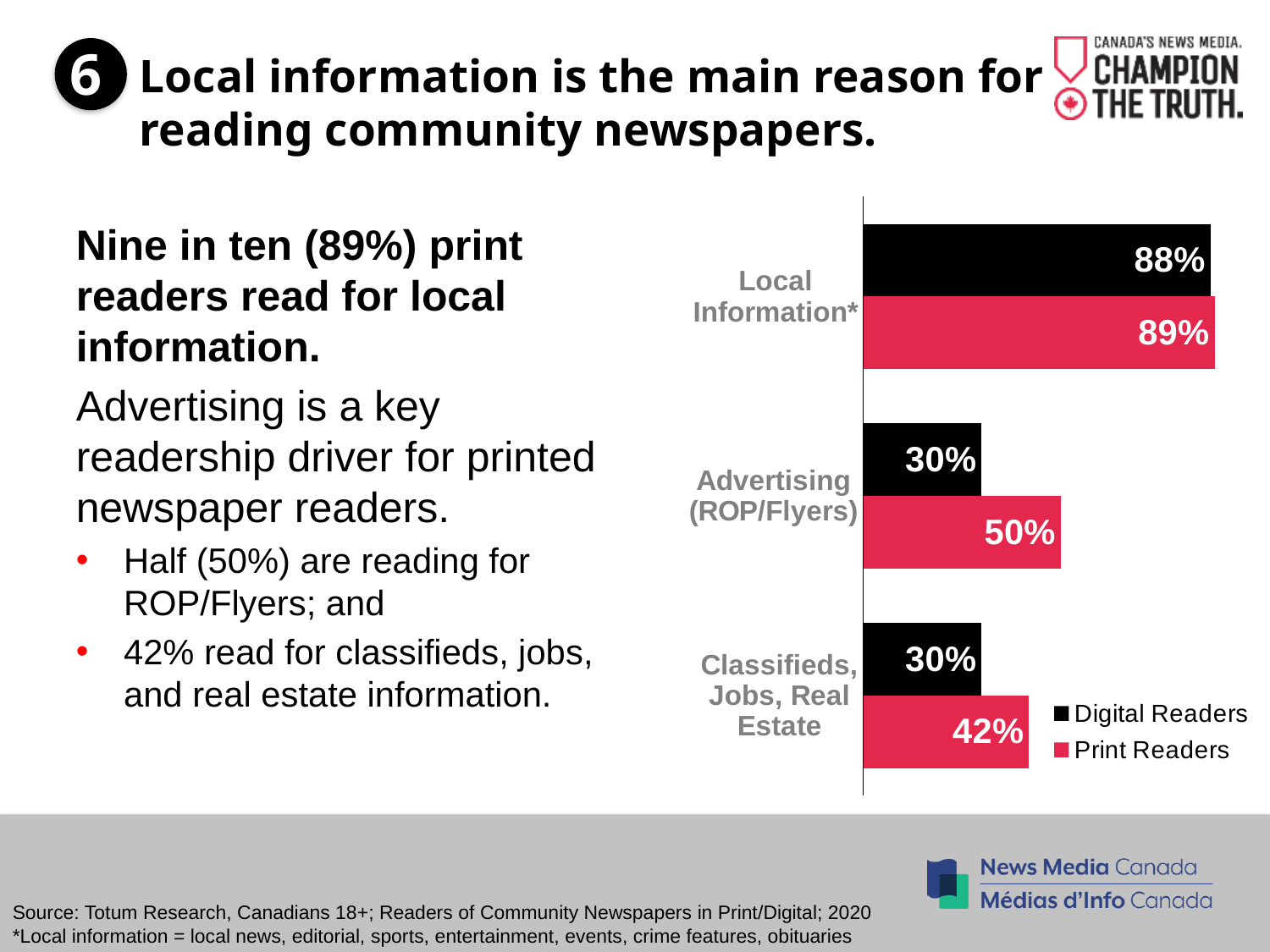
How many series does the legend list? 2 What is the difference between Print Readers and Digital Readers for Classifieds, Jobs, Real Estate? 12% What percentage of Print Readers read for Classifieds, Jobs, Real Estate? 42% What percentage of Print Readers read for Local Information? 89% Which category has the lowest value for Print Readers? Classifieds, Jobs, Real Estate What kind of chart is shown on the slide? Bar chart Which is larger for Advertising (ROP/Flyers): Digital Readers or Print Readers? Print Readers How many categories are shown in the chart? 3 Which category has the highest value for Print Readers? Local Information What is the difference between Print Readers and Digital Readers for Advertising (ROP/Flyers)? 20% What percentage of Digital Readers read for Local Information? 88% What percentage of Digital Readers read for Advertising (ROP/Flyers)? 30%